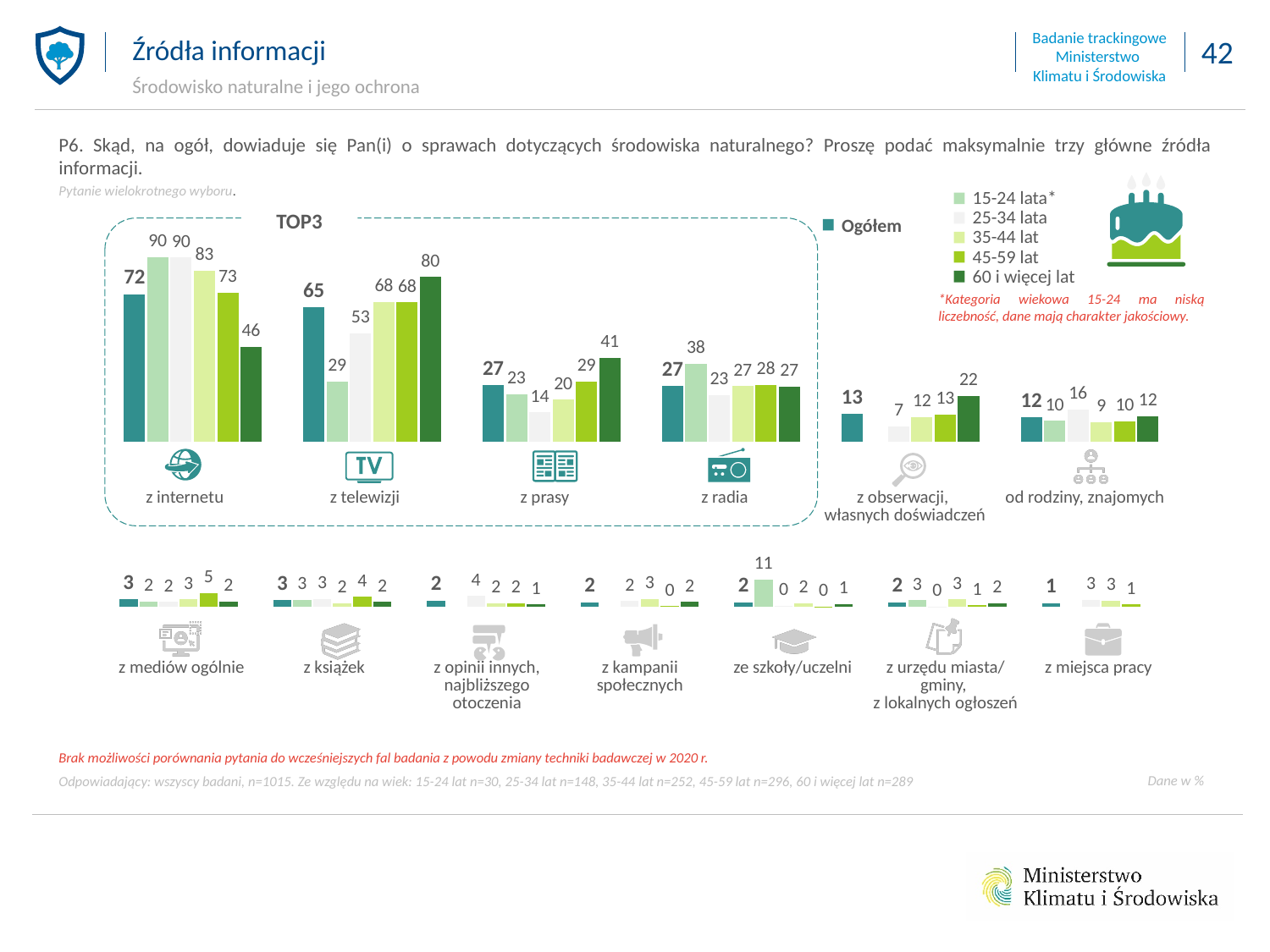
Which source has the highest Ogółem value? z internetu What is the Ogółem (overall) value for 'z internetu'? 72 For 'z internetu', what is the difference between the '25-34 lata' value and the '60 i więcej lat' value? 44 How many information sources (categories) are shown on the slide? 13 For the '60 i więcej lat' group, which is larger: 'z prasy' or 'z radia'? z prasy Which source has the lowest Ogółem value? z miejsca pracy What is the Ogółem value for 'z obserwacji, własnych doświadczeń'? 13 What is the value for the '60 i więcej lat' group for 'z telewizji'? 80 What is the difference between the Ogółem values for 'z internetu' and 'z telewizji'? 7 What kind of chart is shown on the slide? bar chart What is the value for the '15-24 lata' group for 'ze szkoły/uczelni'? 11 How many age groups does the legend list? 5